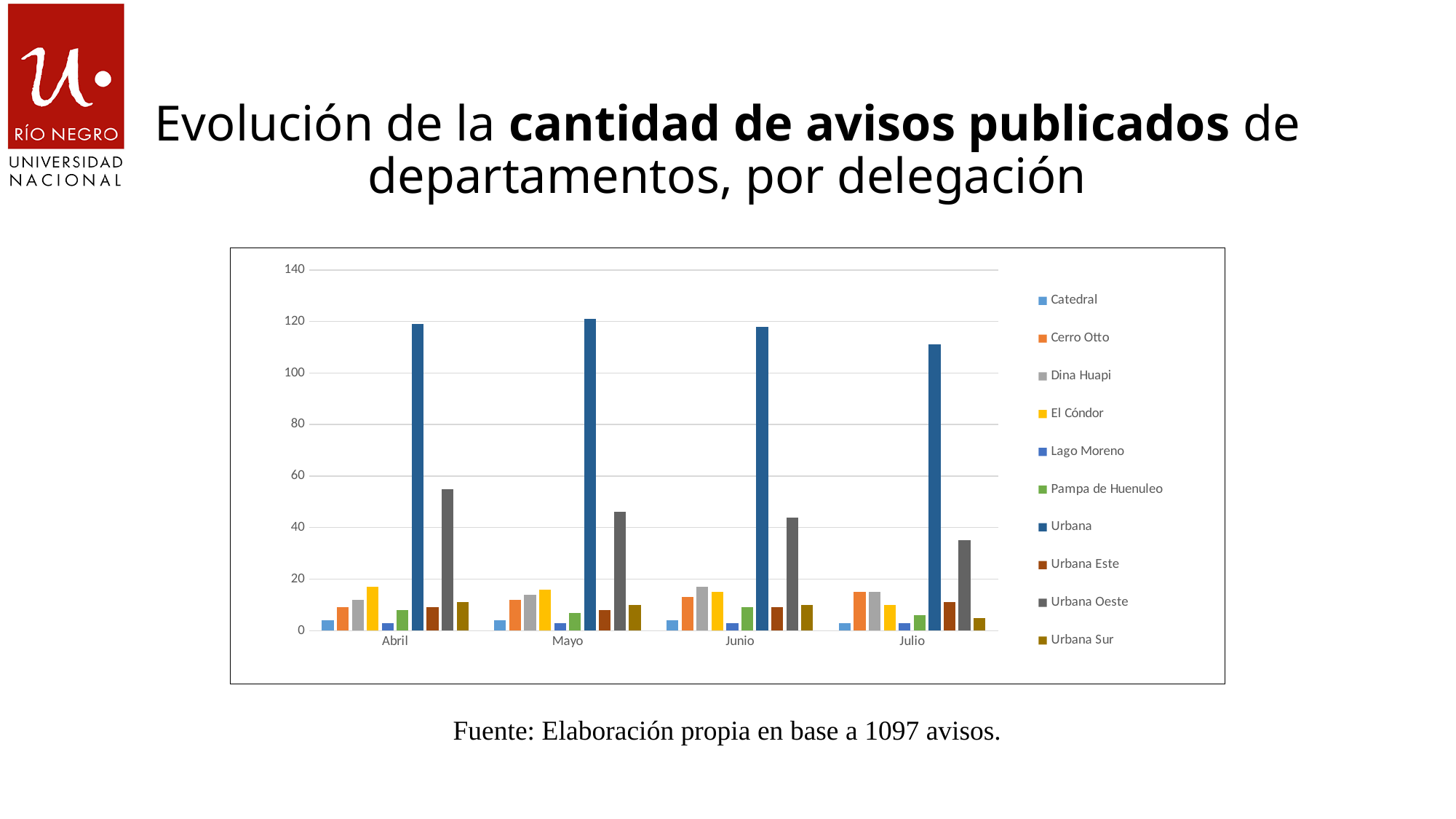
What kind of chart is shown on the slide? bar chart Is the value for Urbana in Abril greater or less than 100? greater How many months are shown on the x axis of the chart? 4 Is the value for Catedral in Abril greater or less than 20? less Which is larger: Urbana Oeste in Abril or Urbana Oeste in Julio? Urbana Oeste in Abril How many series does the chart's legend list? 10 Which delegación has the highest number of avisos in Mayo? Urbana Which delegación has the highest number of avisos in Julio? Urbana What colour represents the Urbana series in the chart's legend? dark blue Is the value for Urbana Oeste in Julio greater or less than 40? less Do the values for Urbana Oeste rise or fall from Abril to Julio? fall